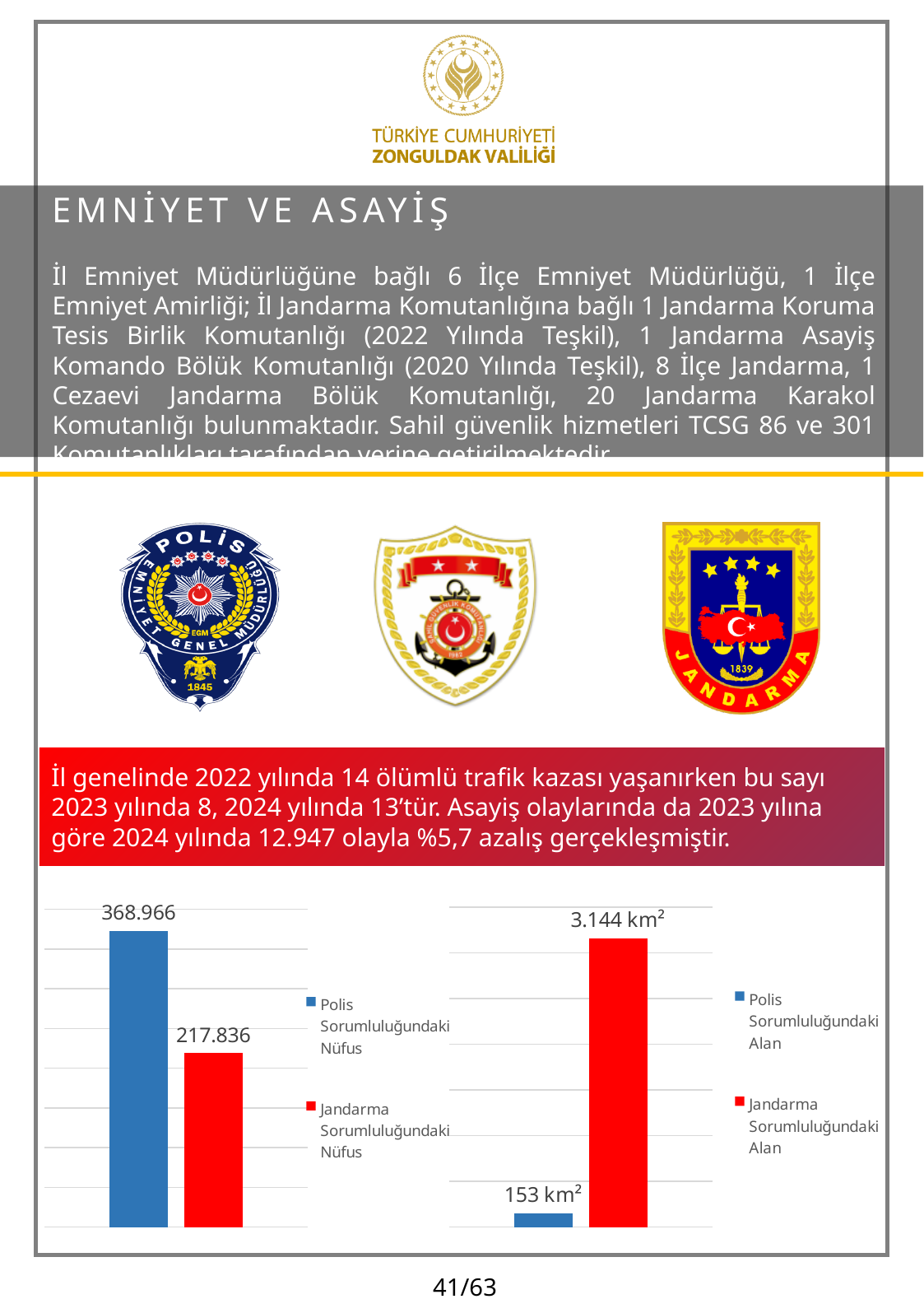
In the left chart, what is the value for Jandarma Sorumluluğundaki Nüfus? 217.836 How many series does the legend of the left chart list? 2 In the left chart, what is the value for Polis Sorumluluğundaki Nüfus? 368.966 In the right chart, which series has the lower value? Polis Sorumluluğundaki Alan In the right chart, what is the value for Polis Sorumluluğundaki Alan? 153 km² In the right chart, what is the value for Jandarma Sorumluluğundaki Alan? 3.144 km² What kind of chart is the right chart? bar chart In the right chart, what colour is the bar for Jandarma Sorumluluğundaki Alan? red In the left chart, which series has the higher value? Polis Sorumluluğundaki Nüfus In the right chart, what is the difference between Jandarma Sorumluluğundaki Alan and Polis Sorumluluğundaki Alan? 2.991 km² In the right chart, is the value for Jandarma Sorumluluğundaki Alan larger or smaller than the value for Polis Sorumluluğundaki Alan? larger In the left chart, what is the difference between Polis Sorumluluğundaki Nüfus and Jandarma Sorumluluğundaki Nüfus? 151.130